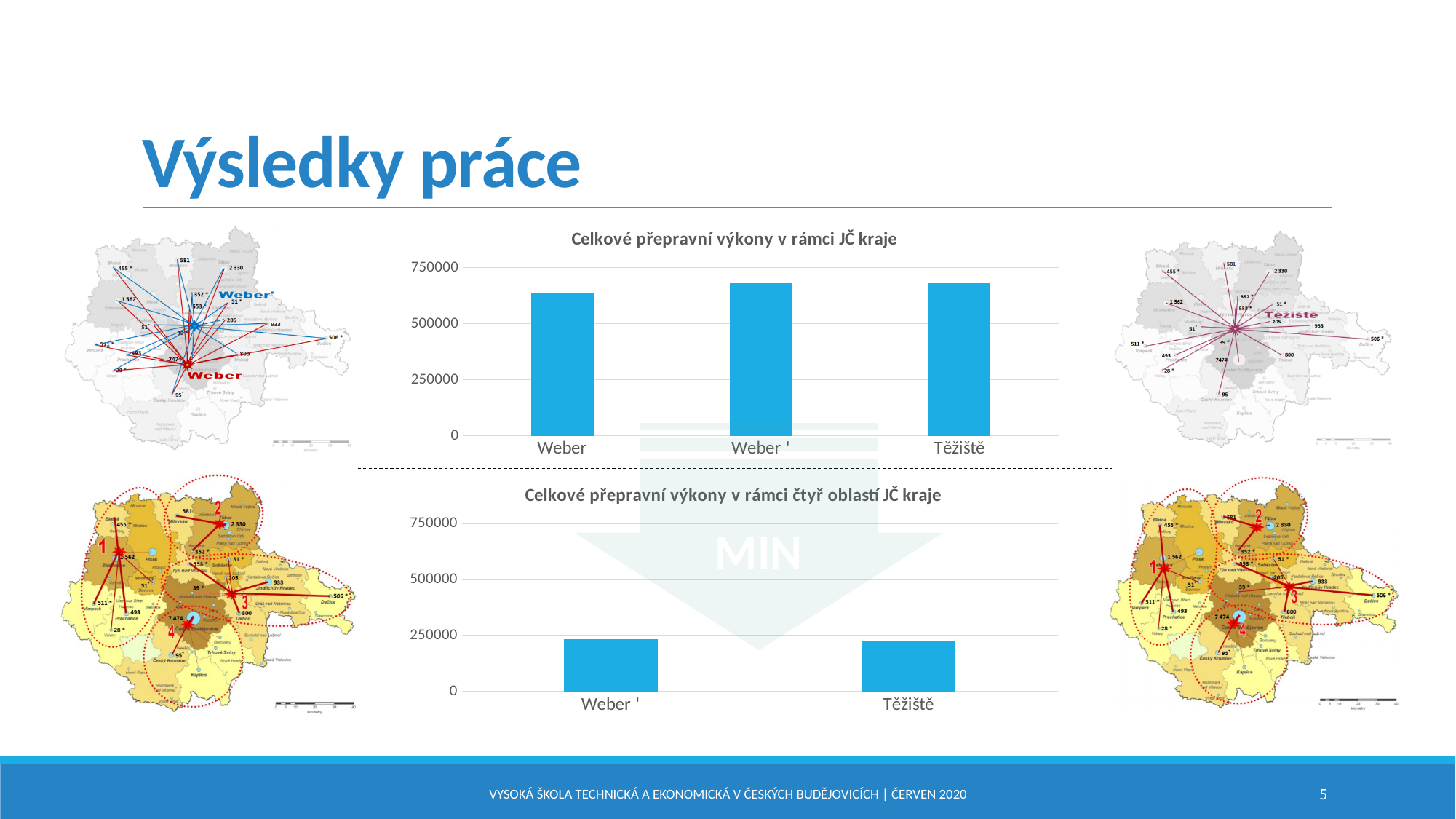
In the bottom chart 'Celkové přepravní výkony v rámci čtyř oblastí JČ kraje', is the value for Těžiště greater or less than 500000? less What is the highest value labelled on the vertical axis of the top chart 'Celkové přepravní výkony v rámci JČ kraje'? 750000 What is the title of the bottom chart on the slide? Celkové přepravní výkony v rámci čtyř oblastí JČ kraje In the top chart 'Celkové přepravní výkony v rámci JČ kraje', is the value for Weber greater or less than 500000? greater What kind of chart is the bottom chart titled 'Celkové přepravní výkony v rámci čtyř oblastí JČ kraje'? bar chart What kind of chart is the top chart titled 'Celkové přepravní výkony v rámci JČ kraje'? bar chart In the bottom chart 'Celkové přepravní výkony v rámci čtyř oblastí JČ kraje', is the value for Weber ' greater or less than 250000? less How many categories are shown in the bottom chart 'Celkové přepravní výkony v rámci čtyř oblastí JČ kraje'? 2 In the top chart 'Celkové přepravní výkony v rámci JČ kraje', which is larger, the value for Weber or the value for Weber '? Weber ' In the top chart 'Celkové přepravní výkony v rámci JČ kraje', which category has the lowest value? Weber How many categories are shown in the top chart 'Celkové přepravní výkony v rámci JČ kraje'? 3